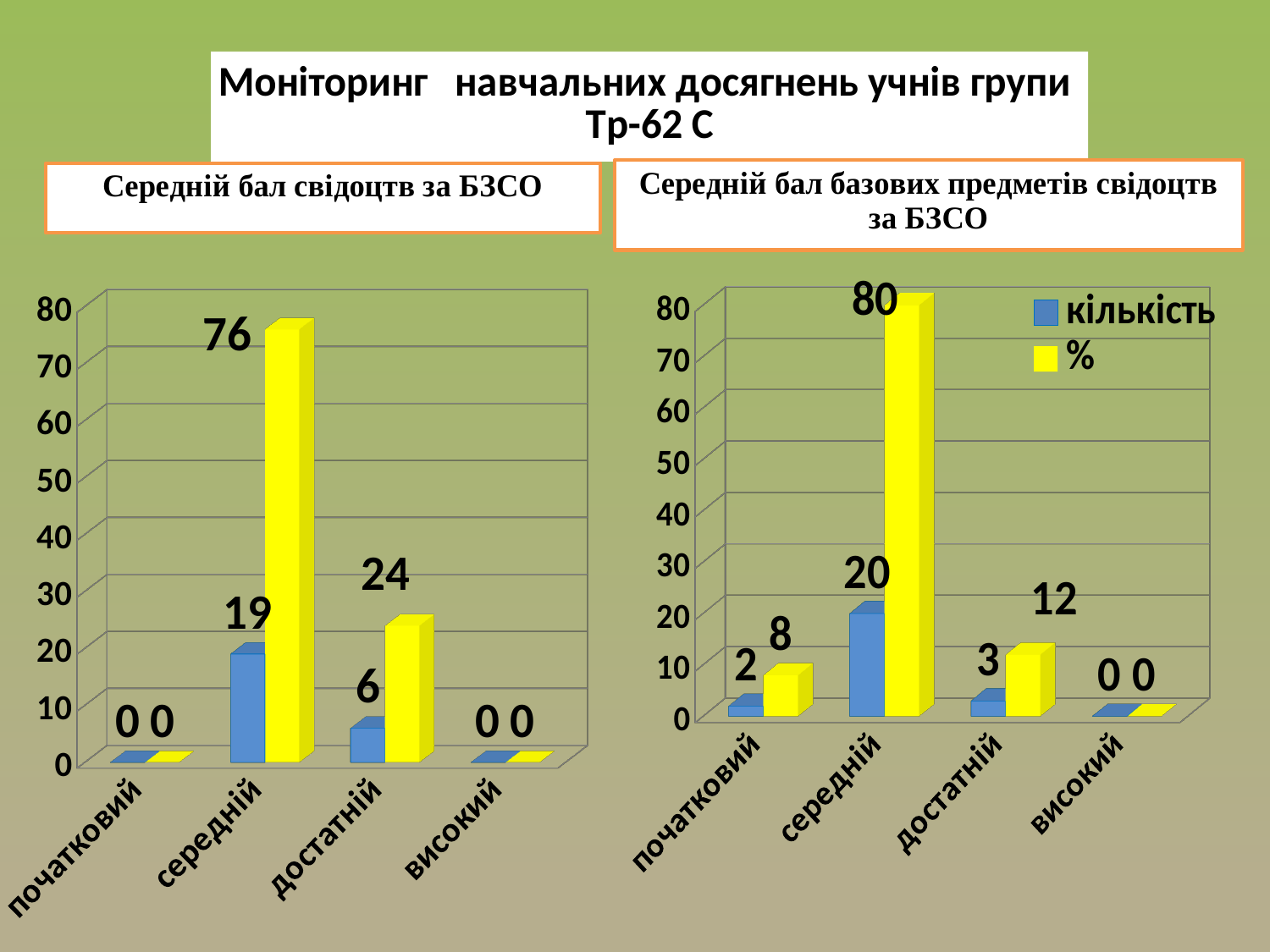
In the right chart (Середній бал базових предметів свідоцтв за БЗСО), what is the % value for початковий? 8 In the left chart (Середній бал свідоцтв за БЗСО), which is larger: the кількість value for середній or the кількість value for достатній? середній In the left chart (Середній бал свідоцтв за БЗСО), what is the difference between the % values for середній and достатній? 52 How many categories are shown on the x axis of the right chart (Середній бал базових предметів свідоцтв за БЗСО)? 4 In the right chart (Середній бал базових предметів свідоцтв за БЗСО), what is the difference between the кількість values for середній and достатній? 17 In the right chart (Середній бал базових предметів свідоцтв за БЗСО), which colour represents the % series? yellow How many series does the legend of the right chart (Середній бал базових предметів свідоцтв за БЗСО) list? 2 What type of chart is the left chart (Середній бал свідоцтв за БЗСО)? bar chart In the left chart (Середній бал свідоцтв за БЗСО), what is the кількість value for достатній? 6 In the left chart (Середній бал свідоцтв за БЗСО), what is the % value for середній? 76 In the right chart (Середній бал базових предметів свідоцтв за БЗСО), what is the кількість value for середній? 20 In the right chart (Середній бал базових предметів свідоцтв за БЗСО), which category has the highest % value? середній